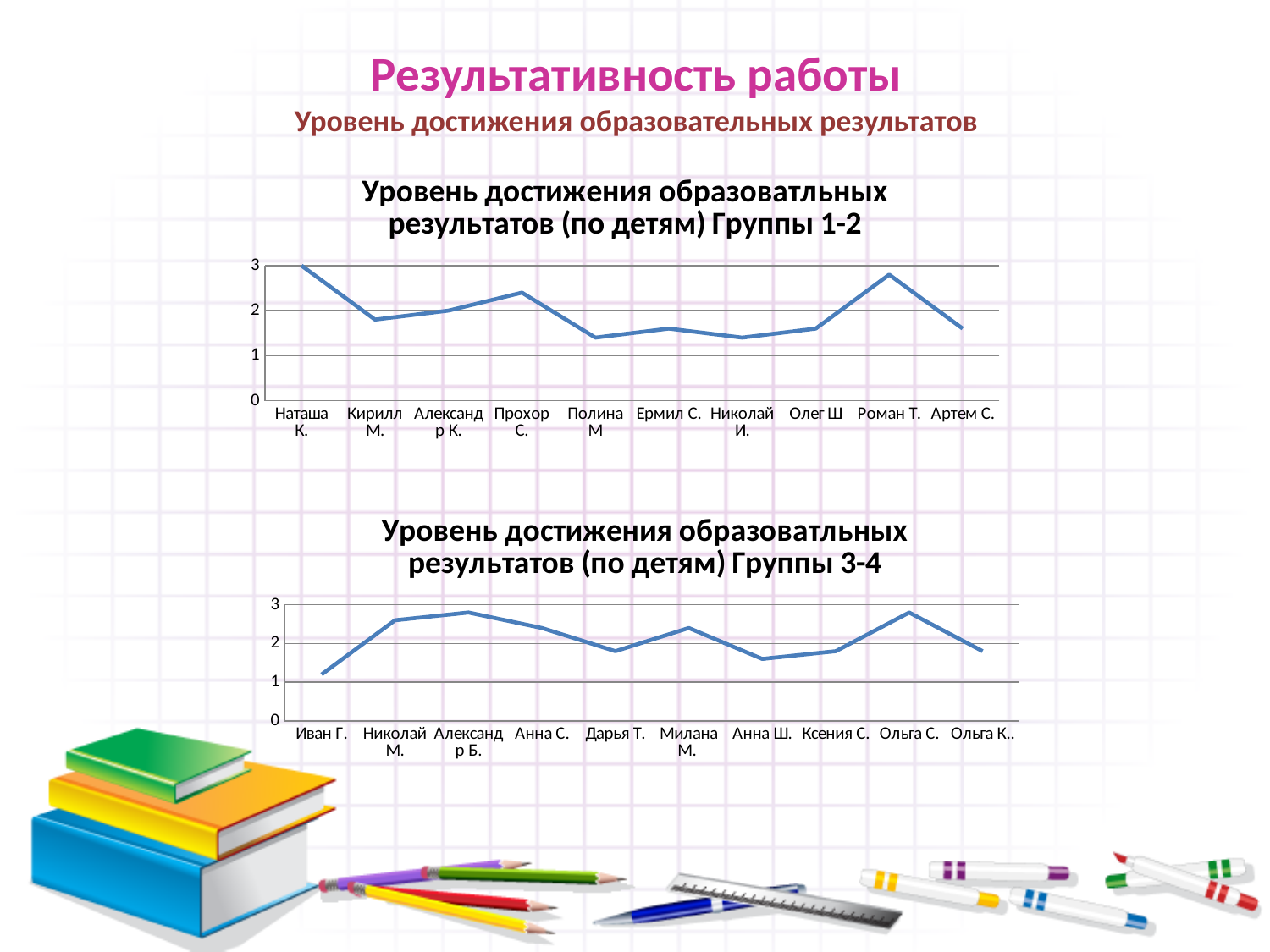
In the chart for Группы 1-2, how many children are shown on the x axis? 10 In the chart for Группы 3-4, how many children are shown on the x axis? 10 In the chart for Группы 1-2, which child has the highest value? Наташа К. In the chart for Группы 3-4, does the line rise or fall from Иван Г. to Николай М.? rise What kind of chart is the chart titled 'Уровень достижения образоватльных результатов (по детям) Группы 1-2'? line chart In the chart for Группы 1-2, which is larger, the value for Наташа К. or the value for Кирилл М.? Наташа К. In the chart for Группы 1-2, is the value for Полина М greater or less than 2? less In the chart for Группы 3-4, is the value for Иван Г. greater or less than 2? less In the chart for Группы 3-4, which child has the lowest value? Иван Г. In the chart for Группы 1-2, is the value for Роман Т. greater or less than 2? greater What kind of chart is the chart titled 'Уровень достижения образоватльных результатов (по детям) Группы 3-4'? line chart In the chart for Группы 3-4, which is larger, the value for Николай М. or the value for Анна Ш.? Николай М.